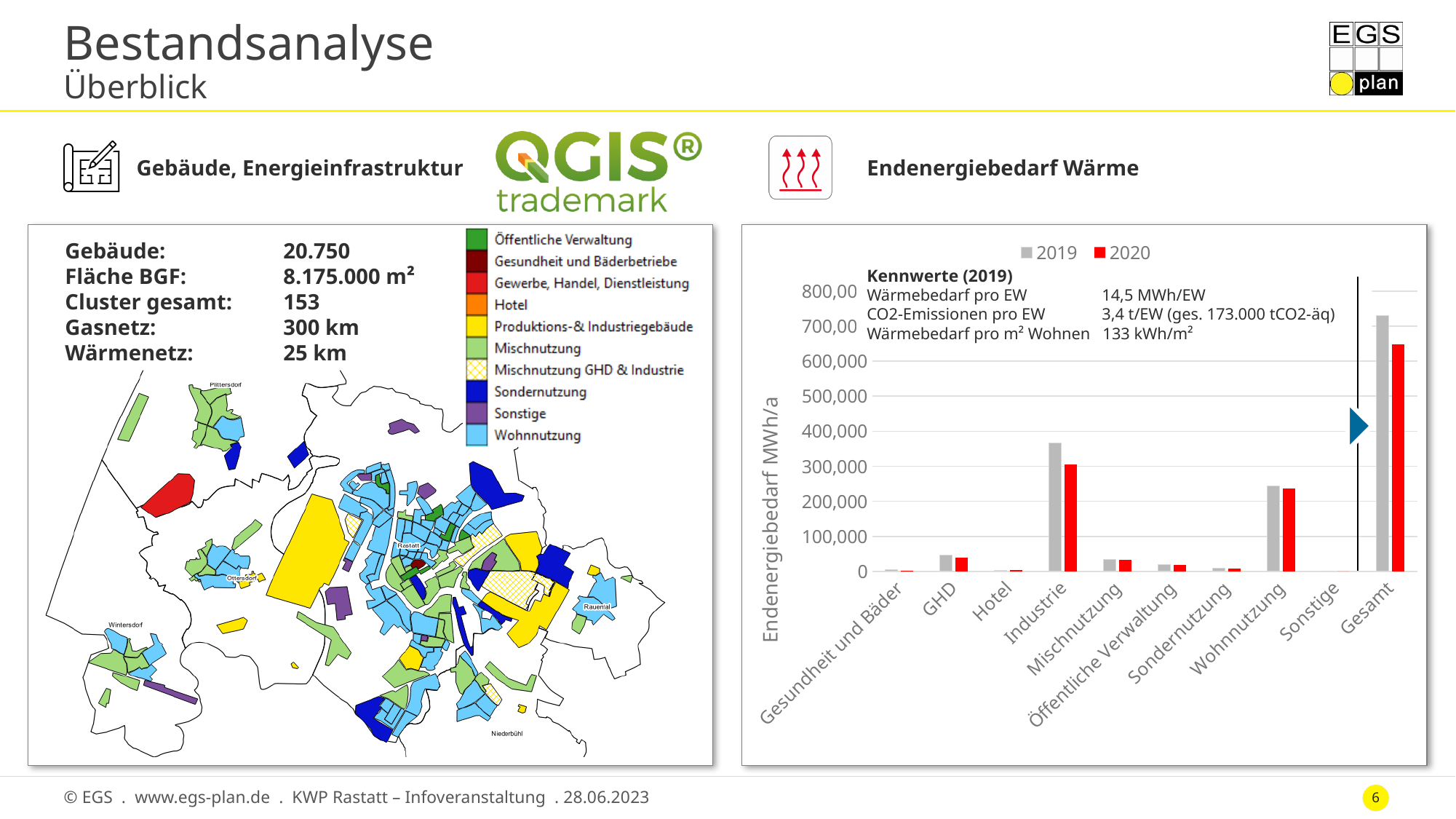
In the 'Endenergiebedarf Wärme' chart, excluding Gesamt, which sector has the highest 2019 value? Industrie What kind of chart is shown under 'Endenergiebedarf Wärme'? bar chart How many series does the legend of the 'Endenergiebedarf Wärme' chart list? 2 In the 'Endenergiebedarf Wärme' chart, which has the larger 2019 value: Industrie or Wohnnutzung? Industrie In the 'Endenergiebedarf Wärme' chart, is the 2020 value for GHD greater or less than 100,000? less How many categories are shown on the x axis of the 'Endenergiebedarf Wärme' chart? 10 In the 'Endenergiebedarf Wärme' chart, which category has the highest 2019 value? Gesamt In the 'Endenergiebedarf Wärme' chart, which is larger for Industrie: the 2019 value or the 2020 value? 2019 In the 'Endenergiebedarf Wärme' chart, is the 2020 value for Gesamt greater or less than 700,000? less In the 'Endenergiebedarf Wärme' chart, which colour represents the 2020 series? red In the 'Endenergiebedarf Wärme' chart, is the 2019 value for Wohnnutzung greater or less than 200,000? greater